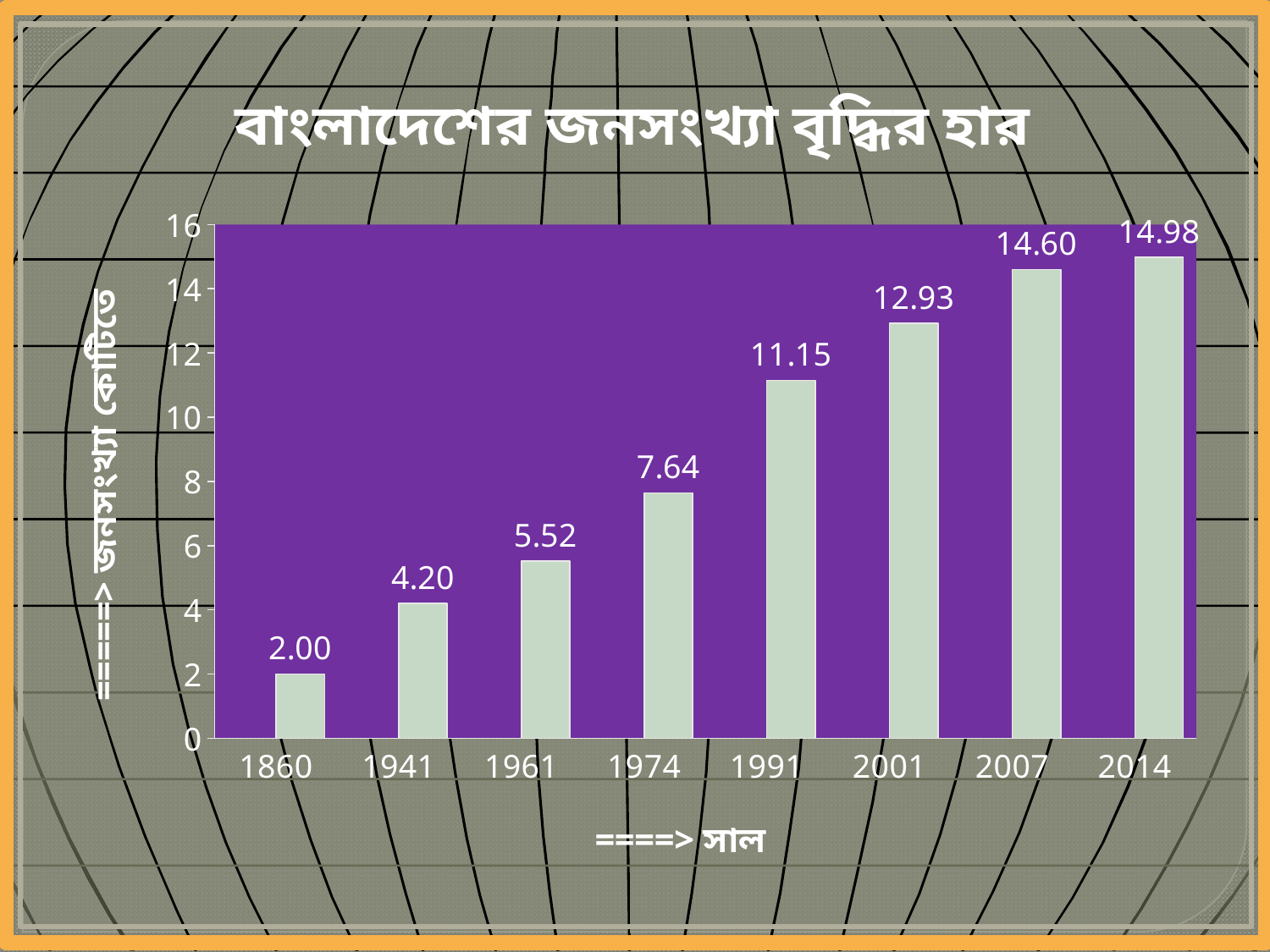
Do the values rise or fall from 1860 to 2014? rise What is the value for 1860? 2.00 What is the difference between the values for 2014 and 2007? 0.38 Which year has the lowest value? 1860 What is the difference between the values for 1991 and 1974? 3.51 Which year has the highest value? 2014 What kind of chart is this? bar chart Which is larger, the value for 1961 or the value for 1941? 1961 What is the value for 1974? 7.64 Is the value for 1991 greater or less than 10? greater What is the value for 2001? 12.93 How many years are shown on the x axis? 8